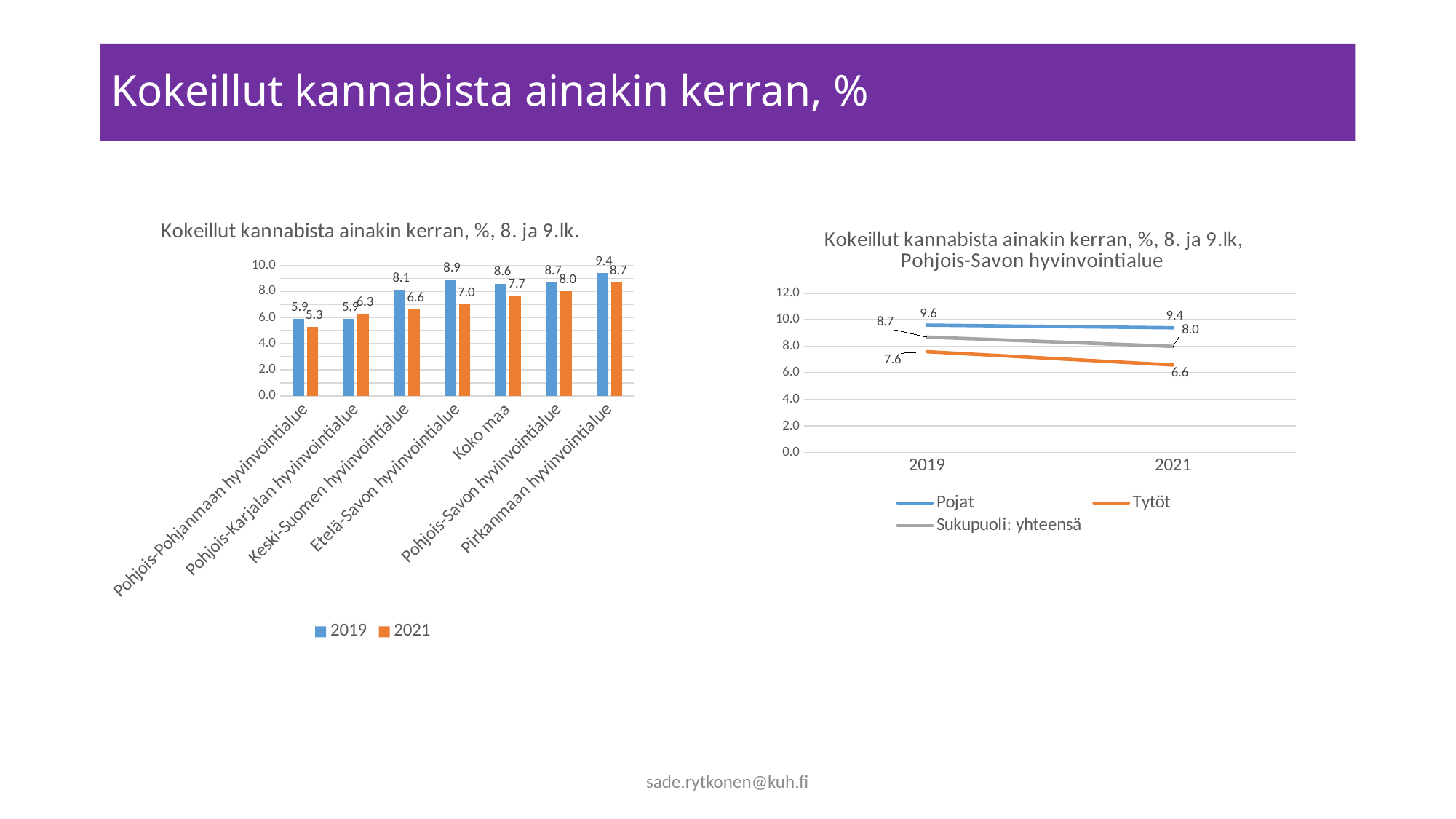
What kind of chart is the chart on the right? Line chart In the left bar chart, which is larger for Pohjois-Karjalan hyvinvointialue: the 2019 value or the 2021 value? 2021 In the left bar chart, what is the difference between the 2019 and 2021 values for Keski-Suomen hyvinvointialue? 1.5 In the left bar chart, which region has the lowest 2021 value? Pohjois-Pohjanmaan hyvinvointialue How many regions (categories) are shown in the left bar chart? 7 In the left bar chart, what is the 2019 value for Etelä-Savon hyvinvointialue? 8.9 In the right line chart, does the Sukupuoli: yhteensä line rise or fall from 2019 to 2021? Fall In the right line chart, what is the value for Tytöt in 2021? 6.6 How many series does the legend of the left chart list? 2 In the right line chart, what is the difference between the Pojat and Tytöt values in 2019? 2.0 In the left bar chart, what is the 2021 value for Pohjois-Savon hyvinvointialue? 8.0 In the left bar chart, which region has the highest 2019 value? Pirkanmaan hyvinvointialue